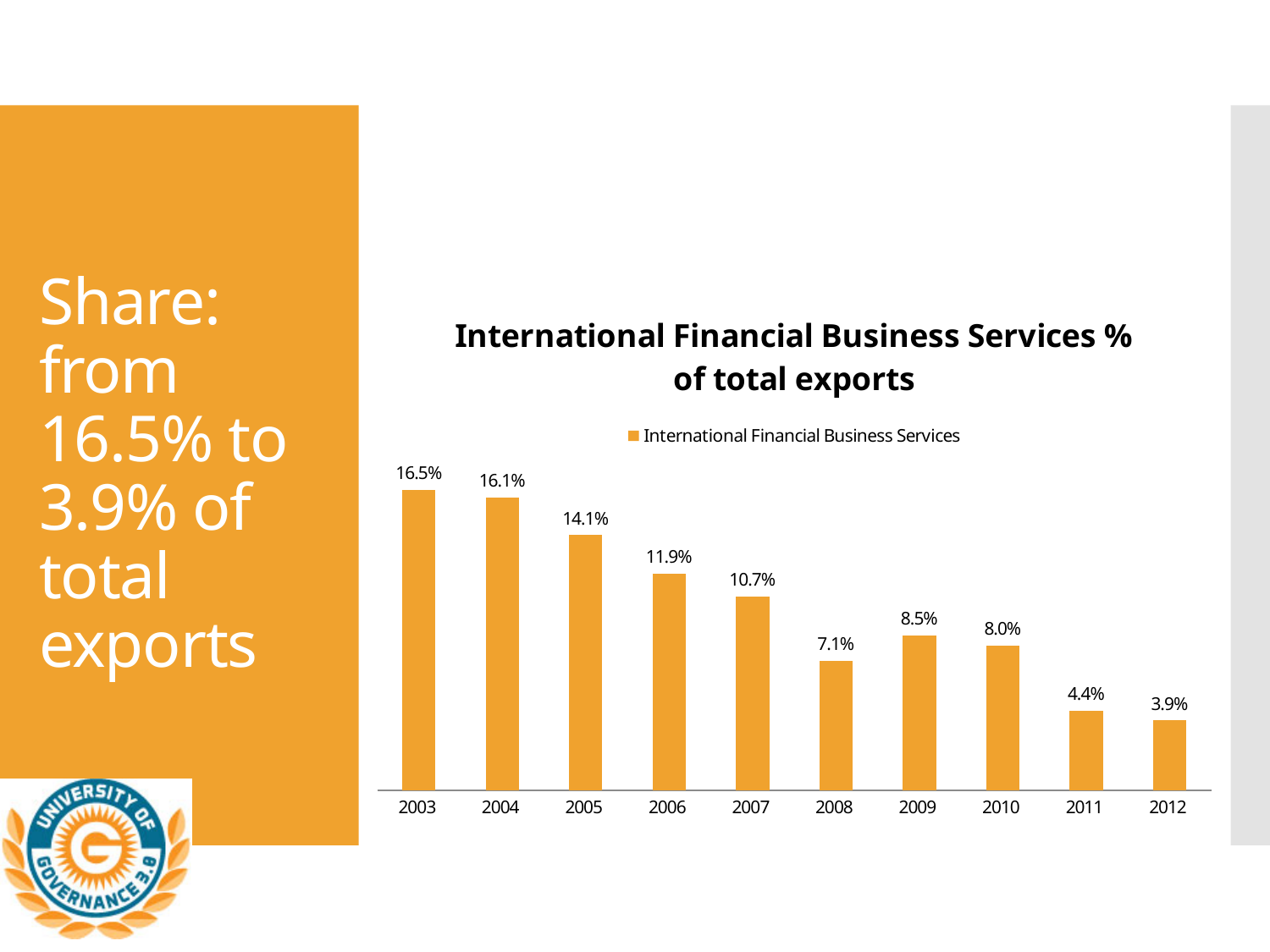
What is the difference between the values for 2003 and 2012? 12.6% How many series does the legend list? 1 What kind of chart is shown? bar chart What is the value for 2012? 3.9% What is the value for 2008? 7.1% What is the difference between the values for 2005 and 2006? 2.2% Which is larger, the value for 2008 or the value for 2009? 2009 Which year has the highest value? 2003 Which year has the lowest value? 2012 What is the title of the chart? International Financial Business Services % of total exports How many years are shown on the x axis? 10 What is the value for 2003? 16.5%